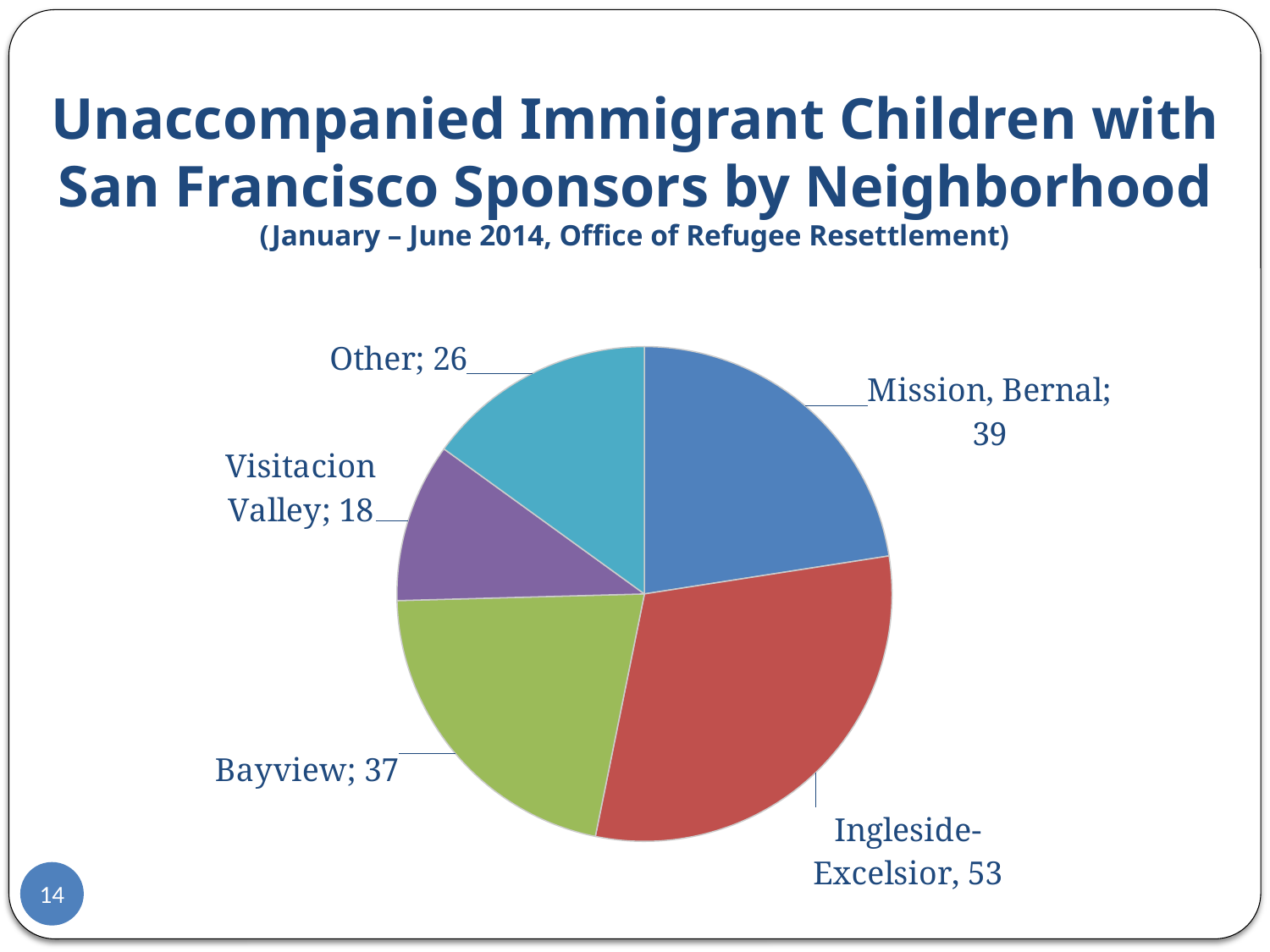
How many neighborhood categories are shown in the pie chart? 5 What is the value for Mission, Bernal? 39 What is the value for Bayview? 37 What is the difference between the values for Ingleside-Excelsior and Bayview? 16 What time period does the chart title say the data covers? January – June 2014 What kind of chart is shown on the slide? Pie chart What is the value for Ingleside-Excelsior? 53 What is the value for Visitacion Valley? 18 Which is larger, the value for Mission, Bernal or the value for Bayview? Mission, Bernal What is the total of all the slices in the pie chart? 173 Which category has the smallest slice of the pie? Visitacion Valley Which neighborhood has the largest slice of the pie? Ingleside-Excelsior